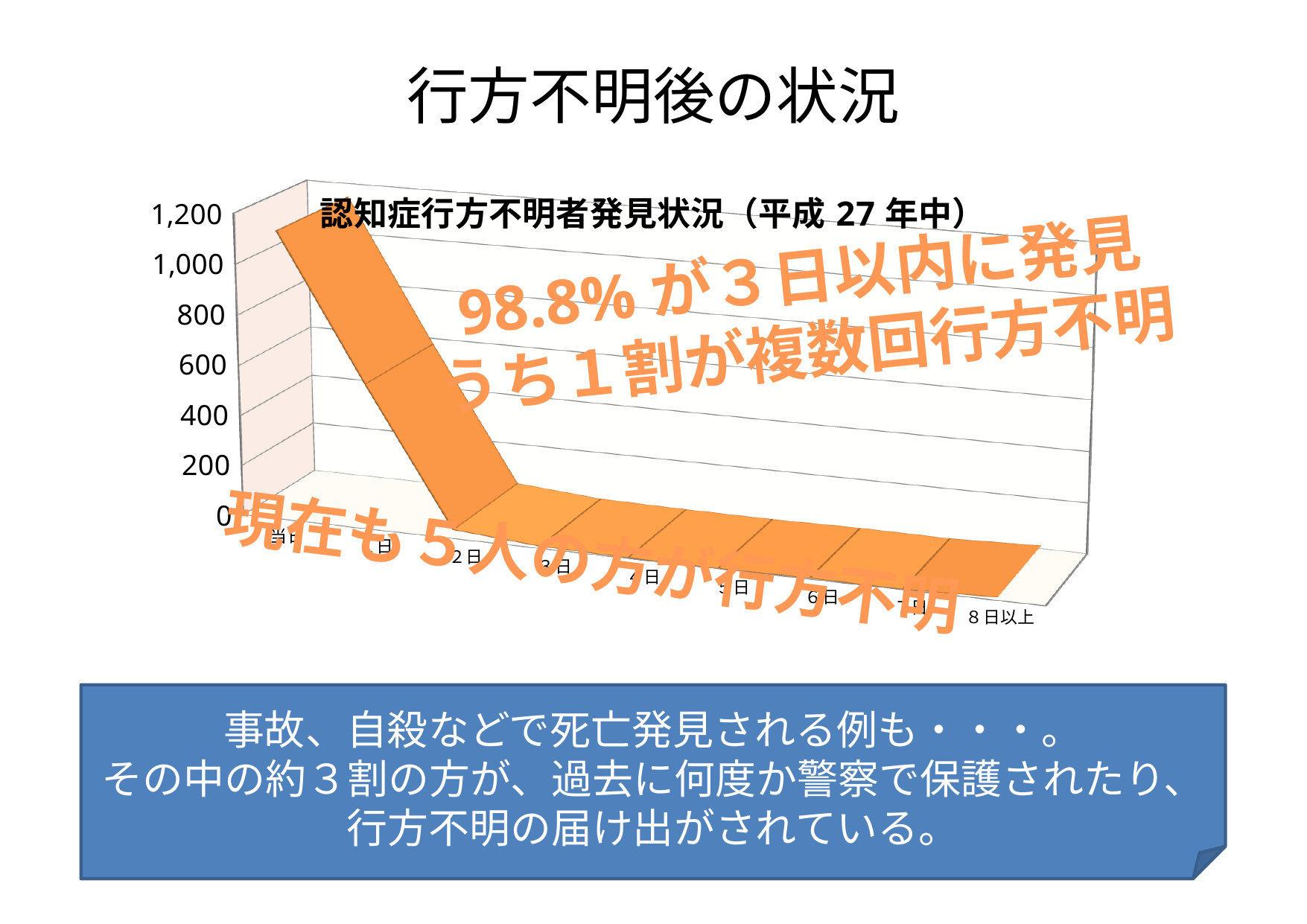
What is the highest tick value shown on the vertical axis? 1,200 Which category has the highest value in the chart? 当日 Is the value for 当日 greater or less than 1,000? greater Which is larger, the value for 1日 or the value for 2日? 1日 Is the value for 8日以上 greater or less than 200? less Is the value for 1日 greater or less than 800? less Do the values rise or fall as you move along the x axis from 当日 to 8日以上? fall What is the title of the chart? 認知症行方不明者発見状況（平成27年中） What kind of chart is shown on the slide? 3D line chart Which is larger, the value for 当日 or the value for 8日以上? 当日